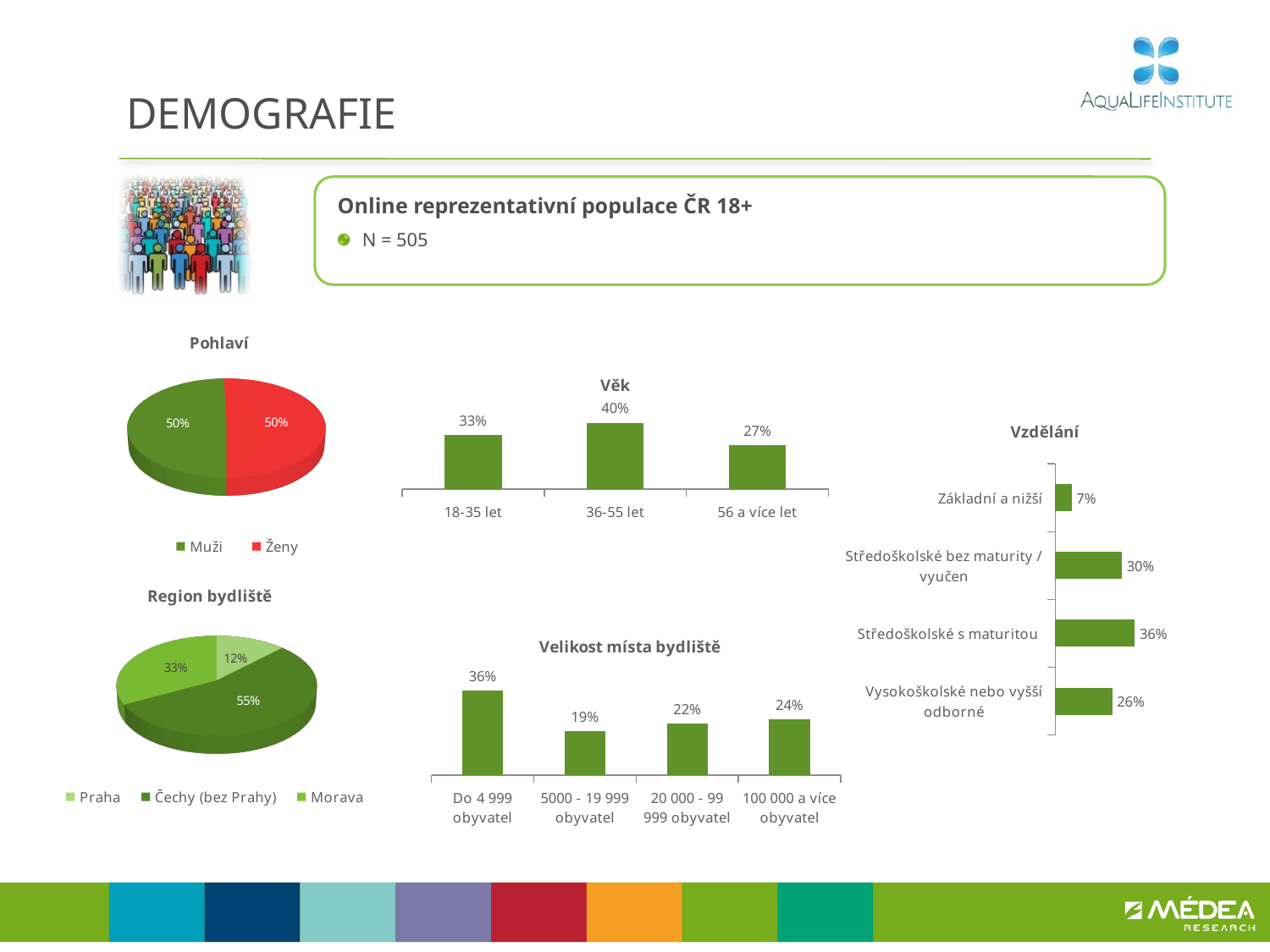
In the 'Vzdělání' chart, what is the value for Základní a nižší? 7% In the 'Věk' chart, which age group has the lowest value? 56 a více let How many categories are shown in the 'Velikost místa bydliště' chart? 4 In the 'Vzdělání' chart, which is larger: Středoškolské bez maturity / vyučen or Vysokoškolské nebo vyšší odborné? Středoškolské bez maturity / vyučen What kind of chart is the 'Vzdělání' chart? Bar chart In the 'Vzdělání' chart, which category has the highest value? Středoškolské s maturitou In the 'Velikost místa bydliště' chart, which category has the highest value? Do 4 999 obyvatel In the 'Region bydliště' pie chart, what is the value of the largest slice? 55% In the 'Velikost místa bydliště' chart, what is the value for 100 000 a více obyvatel? 24% In the 'Věk' chart, what is the value for 36-55 let? 40% In the 'Pohlaví' pie chart, what share does Ženy have? 50% In the 'Věk' chart, what is the difference between the values for 36-55 let and 18-35 let? 7%